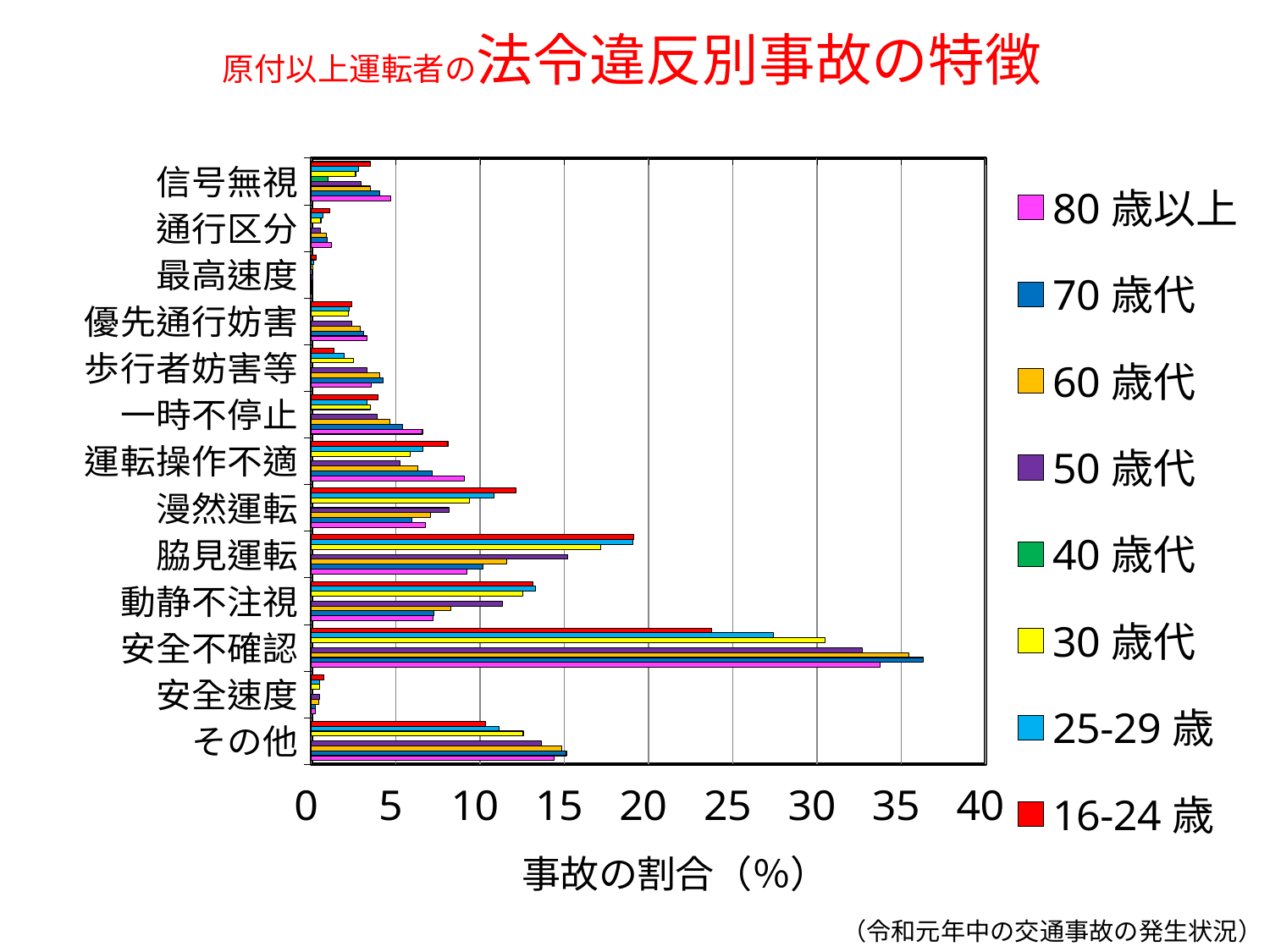
How many violation categories are listed on the vertical axis of the chart? 13 What kind of chart is shown on the slide? bar chart Is the value for 動静不注視 in the 80 歳以上 series greater or less than 10? less Which violation category has the lowest accident share across all age groups? 最高速度 Which violation category has the highest accident share across all age groups? 安全不確認 How many age-group series does the legend list? 8 Is the value for 安全不確認 in the 16-24 歳 series greater or less than 25? less For the 16-24 歳 series, which is larger: 安全不確認 or 脇見運転? 安全不確認 For 脇見運転, which series has the larger value: 16-24 歳 or 80 歳以上? 16-24 歳 What is the label of the horizontal axis of the chart? 事故の割合（%） Is the value for 安全不確認 in the 70 歳代 series greater or less than 35? greater